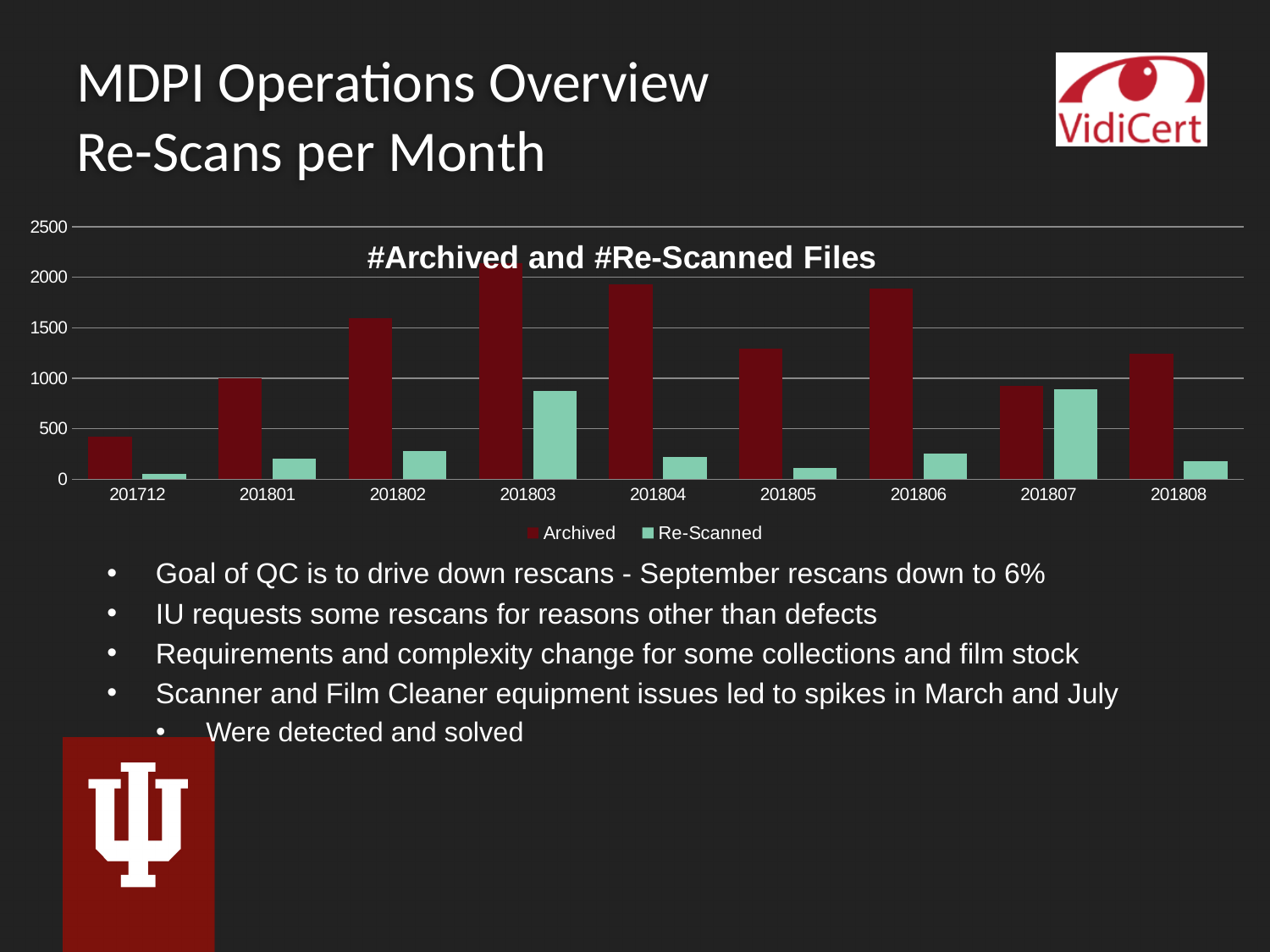
Do the Archived values rise or fall from 201712 to 201803? rise What kind of chart is shown on the slide? bar chart What is the title of the chart? #Archived and #Re-Scanned Files Is the Re-Scanned value for 201803 greater or less than 500? greater Is the Archived value for 201802 greater or less than 1500? greater Which is larger, the Archived value for 201801 or for 201802? 201802 Which month has the lowest Re-Scanned value? 201712 How many months are shown on the x axis of the chart? 9 Which month has the lowest Archived value? 201712 Is the Archived value for 201712 greater or less than 500? less How many series does the chart legend list? 2 Which month has the highest Archived value? 201803